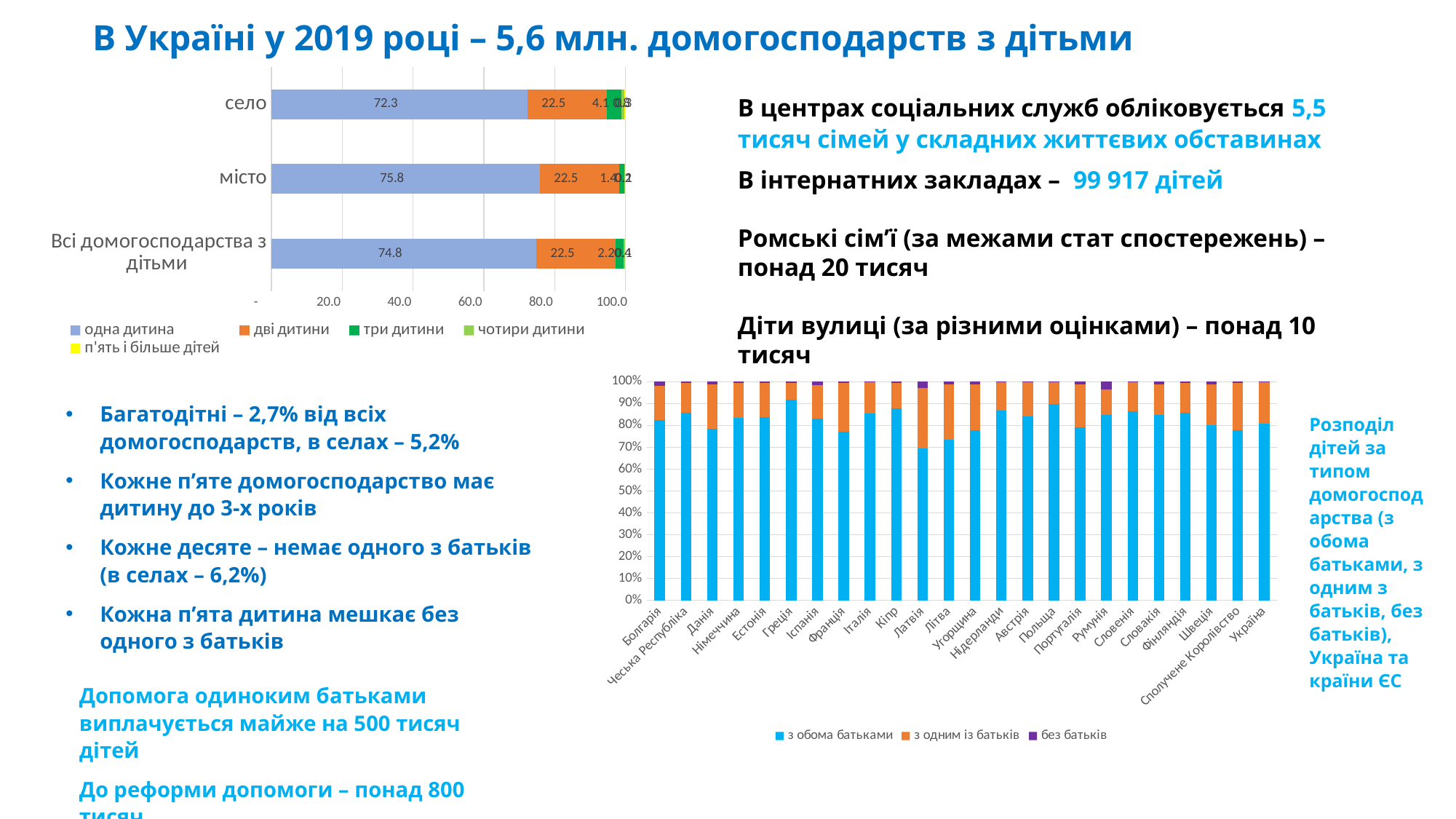
In the top-left chart, which category has the highest value for 'одна дитина'? місто In the top-left chart, what is the difference between the 'одна дитина' values for 'місто' and 'село'? 3.5 In the top-left chart, is the 'три дитини' value larger for 'село' or for 'місто'? село How many countries are shown on the x axis of the bottom-right chart? 24 How many series does the legend of the bottom-right chart list? 3 In the top-left chart, what is the value for 'три дитини' in the 'Всі домогосподарства з дітьми' category? 2.2 How many series does the legend of the top-left chart list? 5 In the top-left chart, what is the value for 'одна дитина' in the 'село' category? 72.3 In the bottom-right chart, which country has the highest share for 'з обома батьками'? Греція In the top-left chart, what is the value for 'три дитини' in the 'село' category? 4.1 In the top-left chart, what is the value for 'одна дитина' in the 'місто' category? 75.8